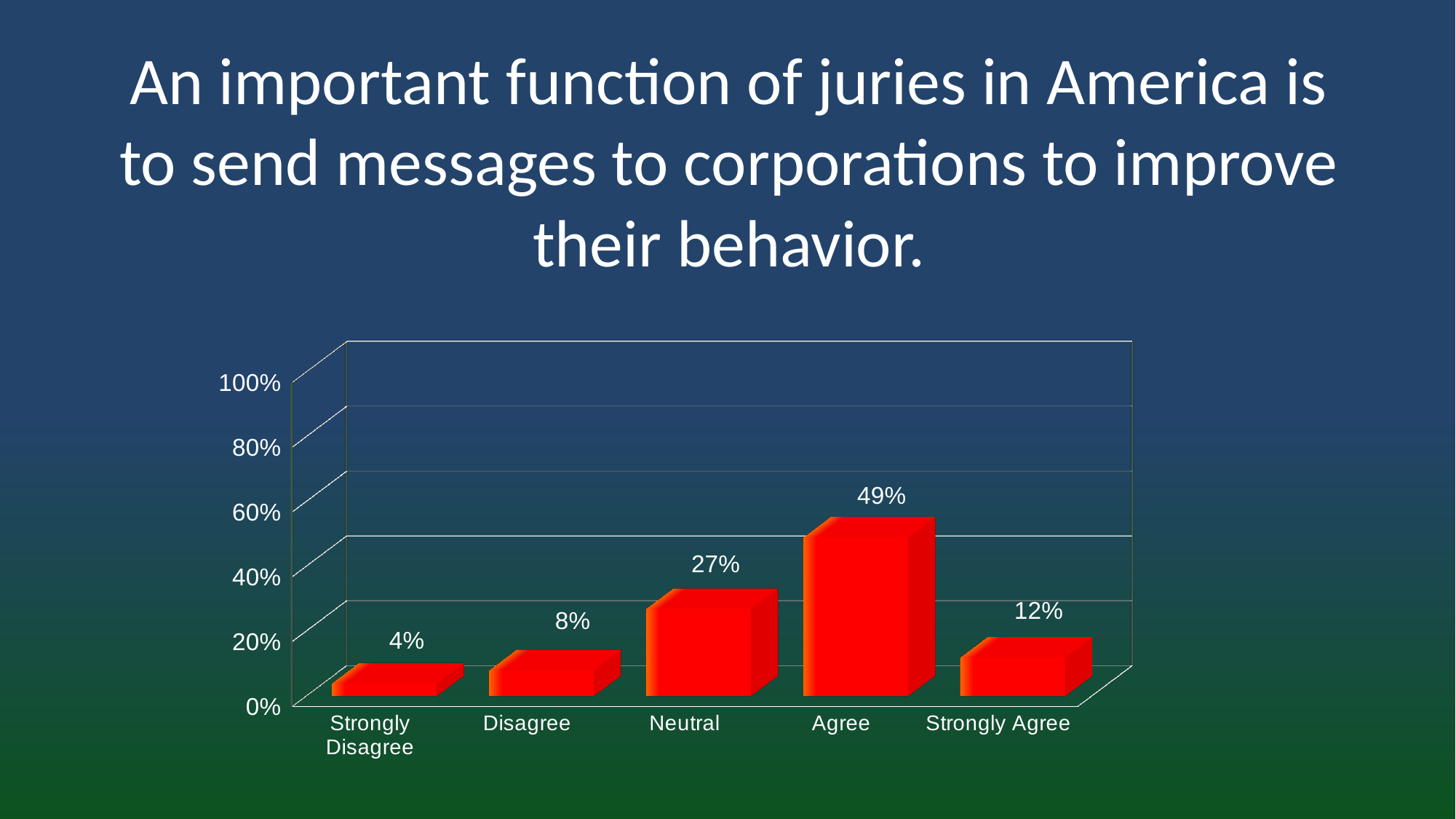
How many response categories are shown on the x axis? 5 What percentage is shown for Neutral? 27% What is the value for Strongly Agree? 12% What is the value shown for Strongly Disagree? 4% Which response category has the highest value? Agree What is the difference between the Agree and Neutral values? 22% Which is larger, the value for Neutral or the value for Strongly Agree? Neutral What kind of chart is shown on the slide? Bar chart What colour are the bars in the chart? Red Which response category has the lowest value? Strongly Disagree What percentage of respondents answered Agree? 49% What is the difference between the Strongly Agree and Disagree values? 4%